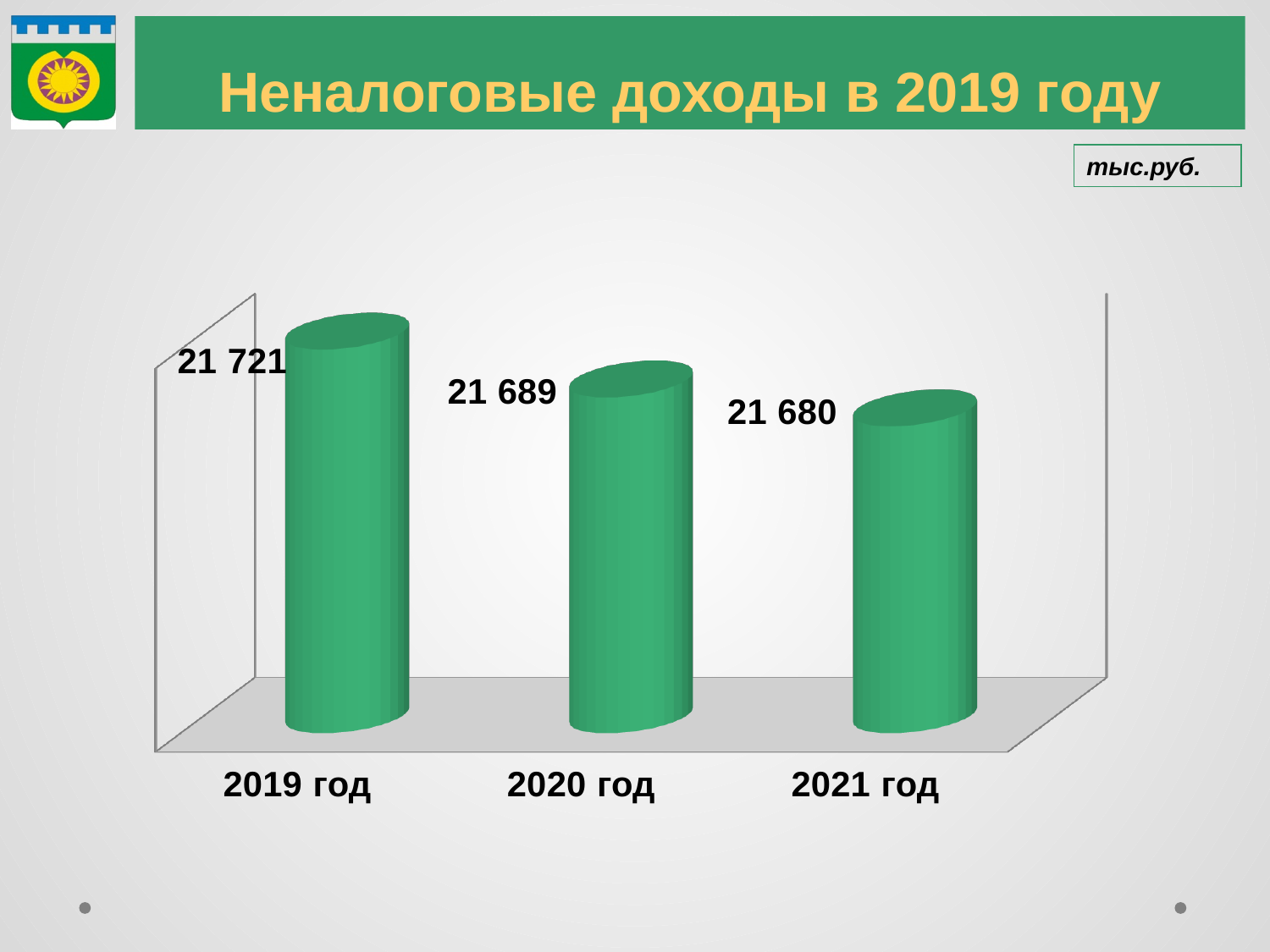
What is the difference between the values for 2019 год and 2021 год? 41 What is the difference between the values for 2020 год and 2021 год? 9 Which year has the lowest value? 2021 год What unit is indicated for the chart values? тыс.руб. How many categories are shown on the chart? 3 What is the value for 2020 год? 21 689 Which year has the highest value? 2019 год What is the difference between the values for 2019 год and 2020 год? 32 Do the values rise or fall from 2019 год to 2021 год? fall What is the value for 2021 год? 21 680 What is the value for 2019 год? 21 721 What kind of chart is shown on the slide? bar chart